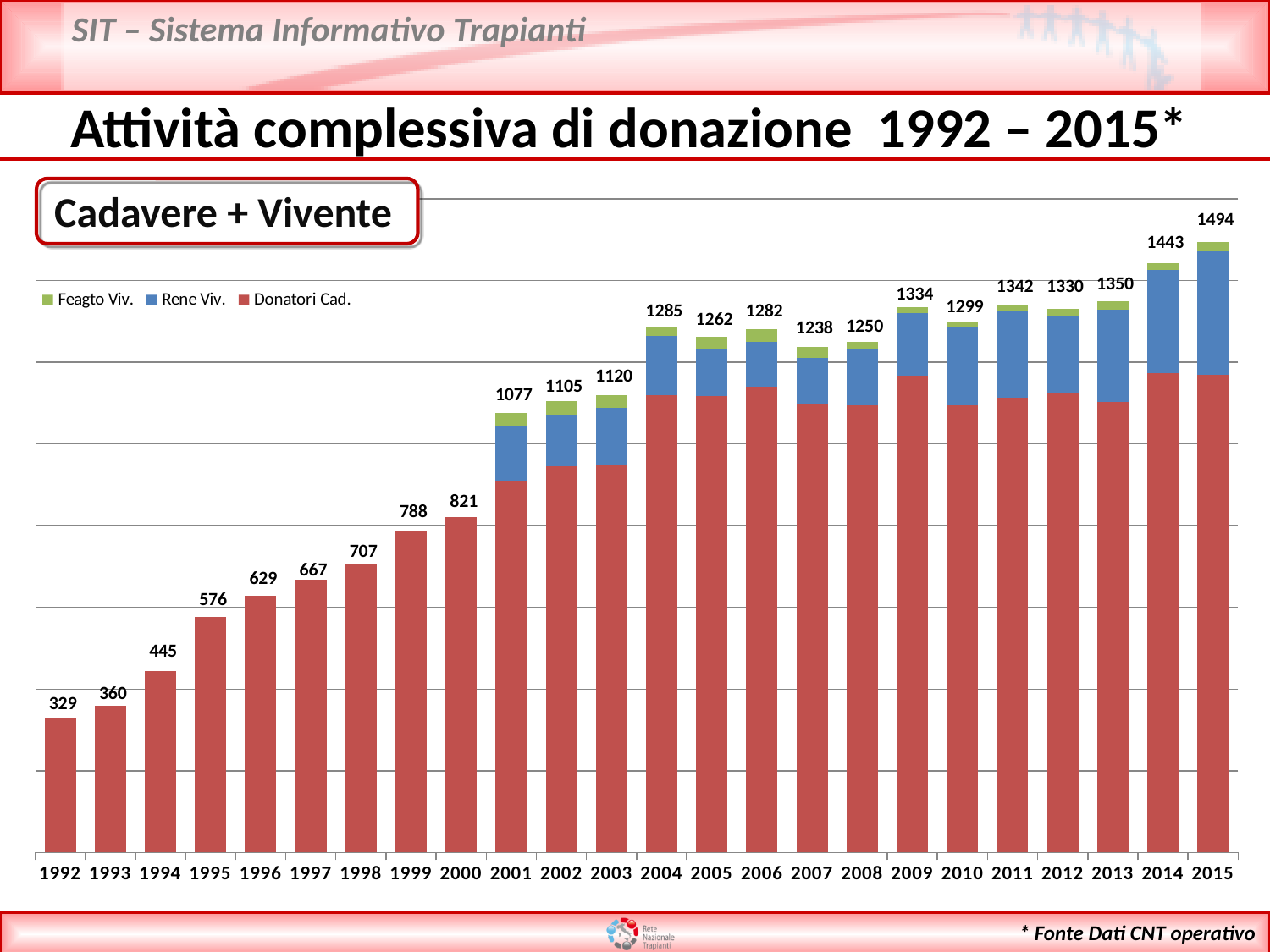
What is the total value labelled for 2004? 1285 Which series is shown in red in the legend? Donatori Cad. What is the total donation activity shown for 2015? 1494 Which year has a larger total, 2007 or 2008? 2008 Which year has the lowest total? 1992 How many series does the legend list? 3 What is the difference between the totals for 2015 and 2014? 51 Which year has the highest total? 2015 What is the total value labelled for 1992? 329 What is the difference between the totals for 2001 and 2000? 256 How many years are shown on the x axis? 24 What kind of chart is shown? Stacked bar chart